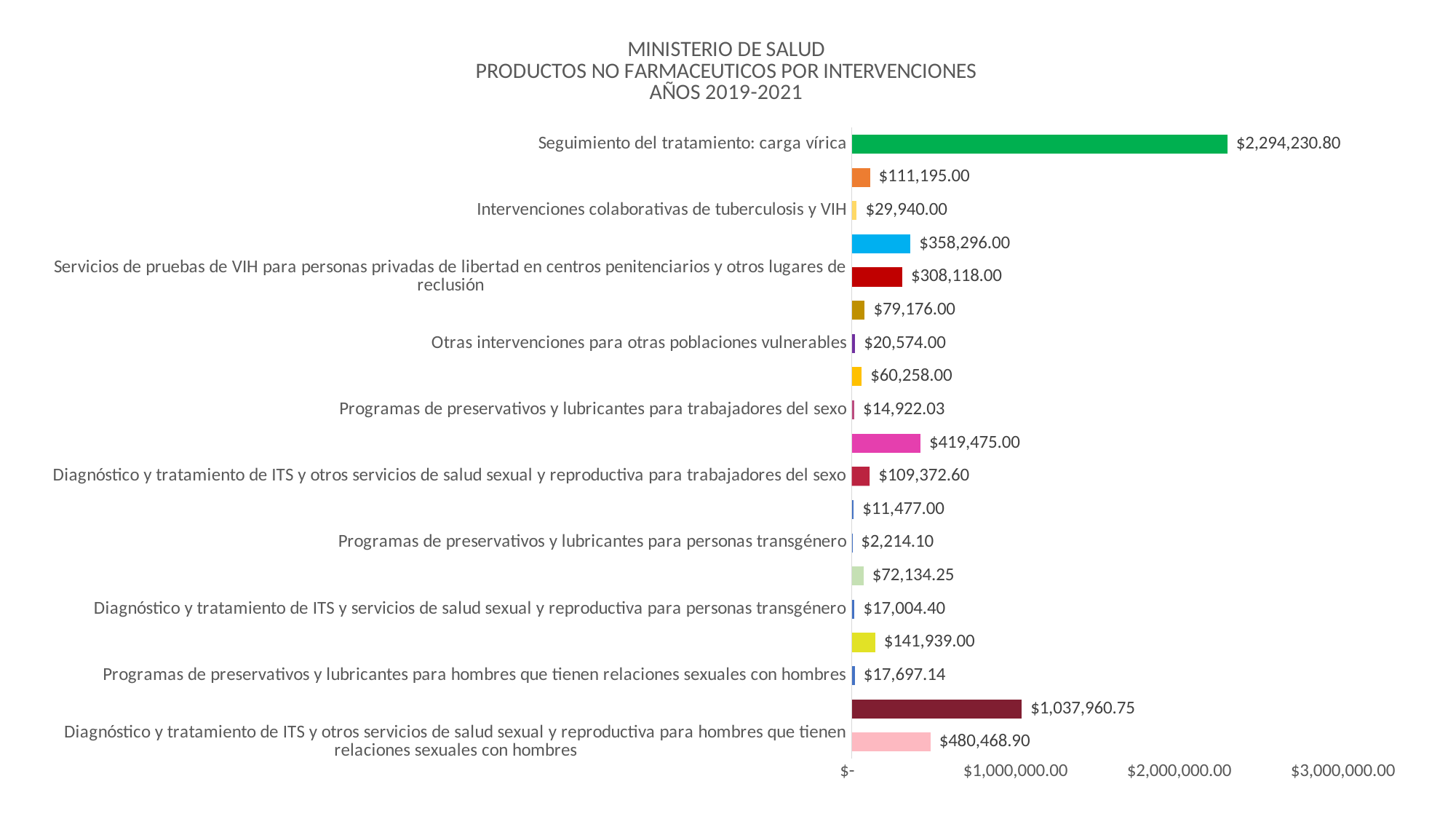
What is the value for 'Diagnóstico y tratamiento de ITS y otros servicios de salud sexual y reproductiva para hombres que tienen relaciones sexuales con hombres'? $480,468.90 Is the value for 'Seguimiento del tratamiento: carga vírica' greater or less than $2,000,000.00? greater How many bars are plotted in the chart? 19 What is the difference between 'Seguimiento del tratamiento: carga vírica' and 'Diagnóstico y tratamiento de ITS y otros servicios de salud sexual y reproductiva para hombres que tienen relaciones sexuales con hombres'? $1,813,761.90 What is the value for 'Seguimiento del tratamiento: carga vírica'? $2,294,230.80 What is the value for 'Intervenciones colaborativas de tuberculosis y VIH'? $29,940.00 Which category has the highest value? Seguimiento del tratamiento: carga vírica What kind of chart is shown on the slide? Bar chart What is the value for 'Programas de preservativos y lubricantes para personas transgénero'? $2,214.10 Which is larger: 'Otras intervenciones para otras poblaciones vulnerables' or 'Programas de preservativos y lubricantes para trabajadores del sexo'? Otras intervenciones para otras poblaciones vulnerables What is the value for 'Servicios de pruebas de VIH para personas privadas de libertad en centros penitenciarios y otros lugares de reclusión'? $308,118.00 Which labeled category has the lowest value? Programas de preservativos y lubricantes para personas transgénero